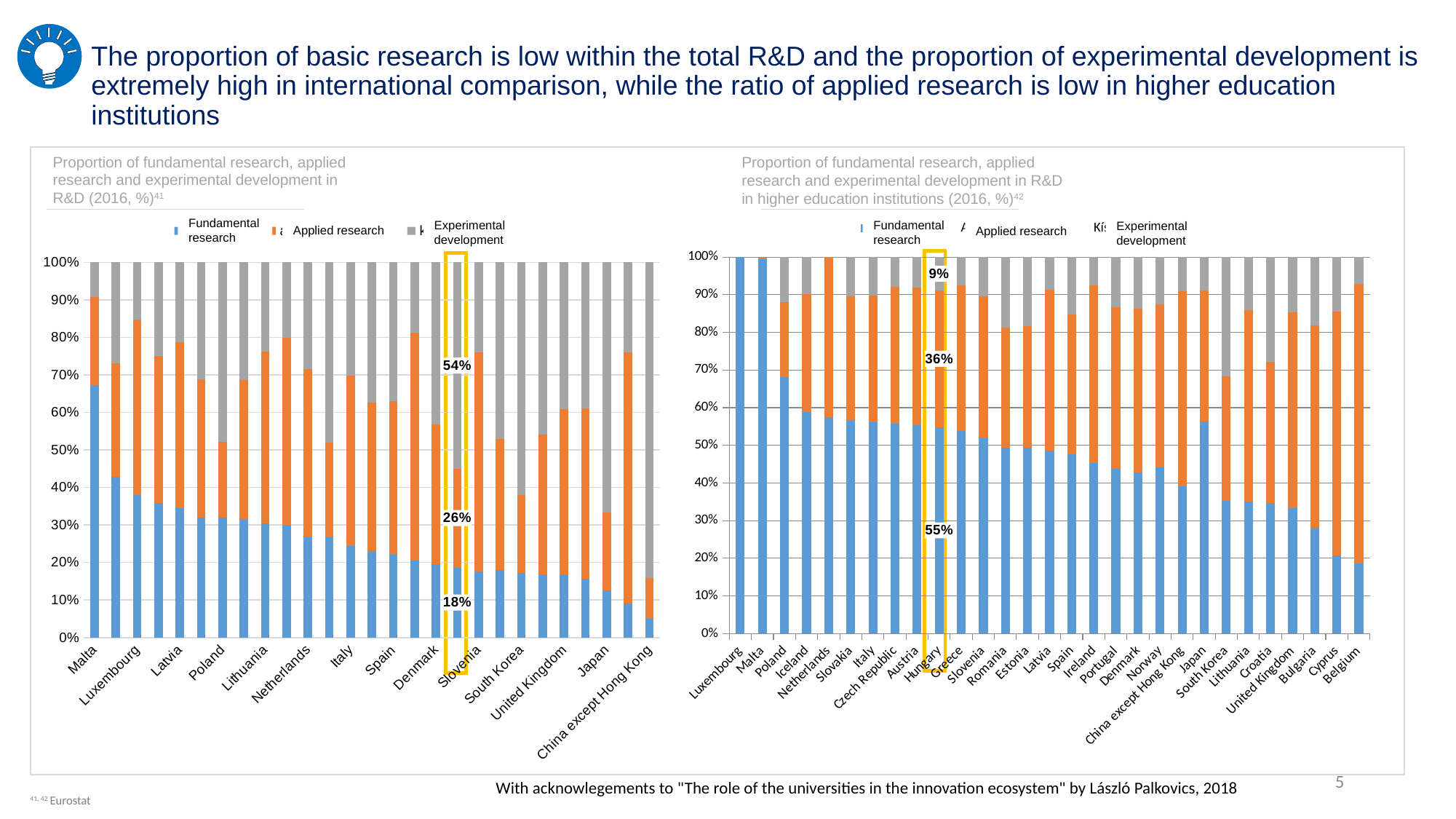
In the left chart (total R&D), what value is labelled for experimental development on the highlighted bar? 54% In the right chart (R&D in higher education institutions), which country has the highest fundamental research share? Luxembourg In the right chart (R&D in higher education institutions), which has the larger fundamental research share, Poland or Belgium? Poland In the right chart (R&D in higher education institutions), what is the applied research share for Hungary? 36% In the left chart (total R&D), what value is labelled for fundamental research on the highlighted bar? 18% In the left chart (total R&D), which country has the highest fundamental research share? Malta In the right chart (R&D in higher education institutions), what is the fundamental research share for Hungary? 55% How many series does the legend of the right chart list? 3 In the right chart (R&D in higher education institutions), is the fundamental research share for Belgium greater or less than 30%? less In the right chart (R&D in higher education institutions), by how many percentage points does Hungary's fundamental research share exceed its applied research share? 19 percentage points What kind of chart is the left chart? Stacked bar chart In the right chart (R&D in higher education institutions), what is the experimental development share for Hungary? 9%